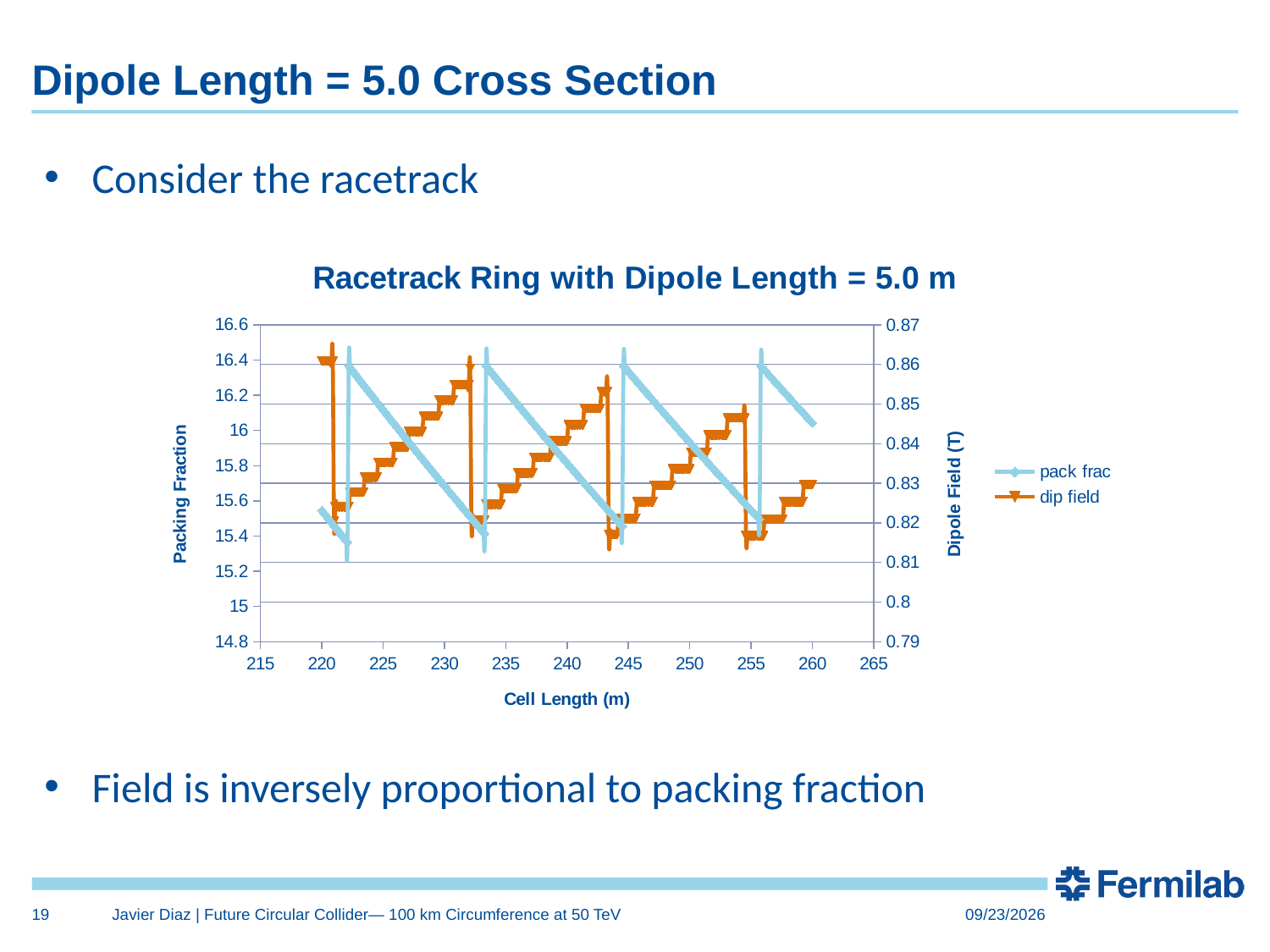
Is the pack frac value at a cell length of 230 m greater or less than 16? less What is the title of the chart? Racetrack Ring with Dipole Length = 5.0 m Is the dip field value at a cell length of 230 m greater or less than 0.83? greater What are the two series named in the legend? pack frac and dip field How many series does the legend list? 2 What kind of chart is shown on the slide? line chart Between cell lengths of about 222 m and 233 m, does the pack frac series rise or fall? fall What is the highest tick value shown on the right-hand Dipole Field (T) axis? 0.87